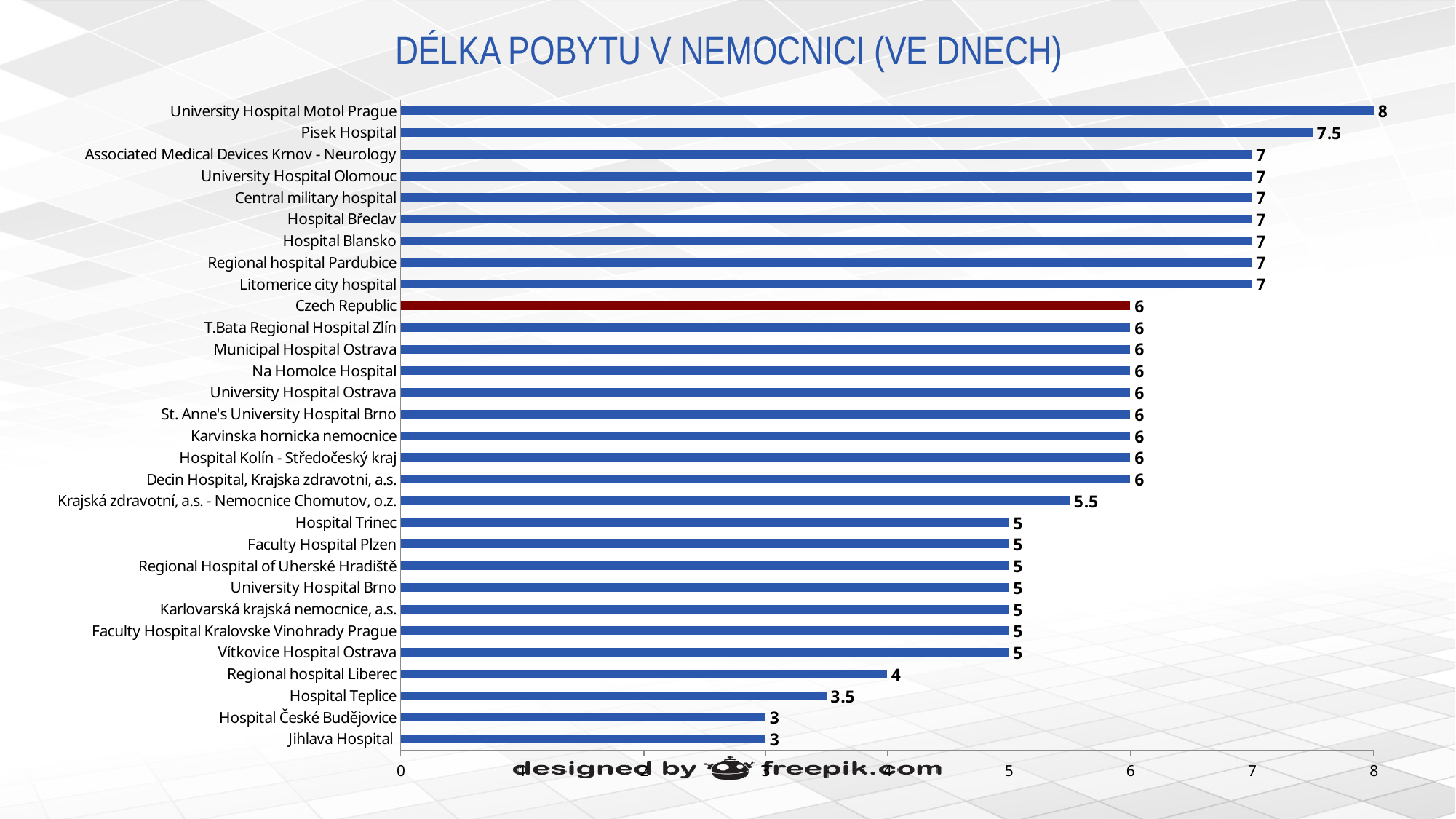
What is the value shown for Czech Republic? 6 What is the length of hospital stay for University Hospital Motol Prague? 8 Which bar is shown in a different colour (dark red) from the others? Czech Republic Which is larger, the value for Hospital Trinec or the value for Hospital Blansko? Hospital Blansko What is the value shown for Pisek Hospital? 7.5 How many categories (bars) are shown in the chart? 30 What is the value shown for Hospital Teplice? 3.5 Which hospital has the highest length of stay? University Hospital Motol Prague What is the difference between the values for University Hospital Motol Prague and Jihlava Hospital? 5 What type of chart is shown on the slide? Bar chart What is the value shown for Krajská zdravotní, a.s. - Nemocnice Chomutov, o.z.? 5.5 What is the difference between the values for Pisek Hospital and Regional hospital Liberec? 3.5